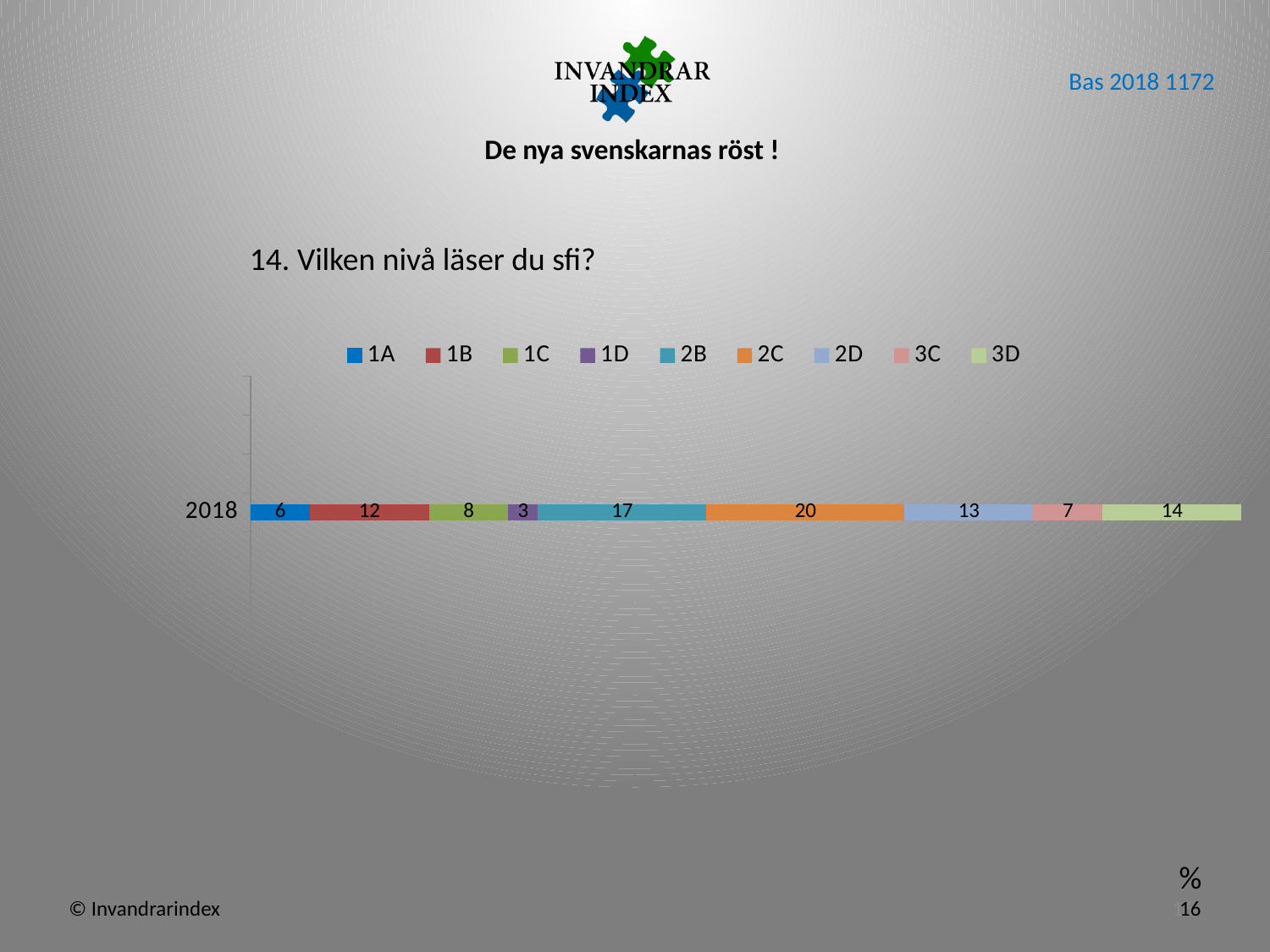
Which is larger, the value for 1B or the value for 2D? 2D What is the total of the stacked bar for 2018? 100 How many series does the legend list? 9 What is the value for 2B in the 2018 bar? 17 Which series has the largest segment in the 2018 bar? 2C What is the value for 3D in the 2018 bar? 14 What is the title of the chart? 14. Vilken nivå läser du sfi? What is the value for 1D in the 2018 bar? 3 What kind of chart is shown on the slide? Stacked bar chart How many categories are shown on the vertical axis? 1 What is the difference between the values for 2C and 1A? 14 Which series has the smallest segment in the 2018 bar? 1D